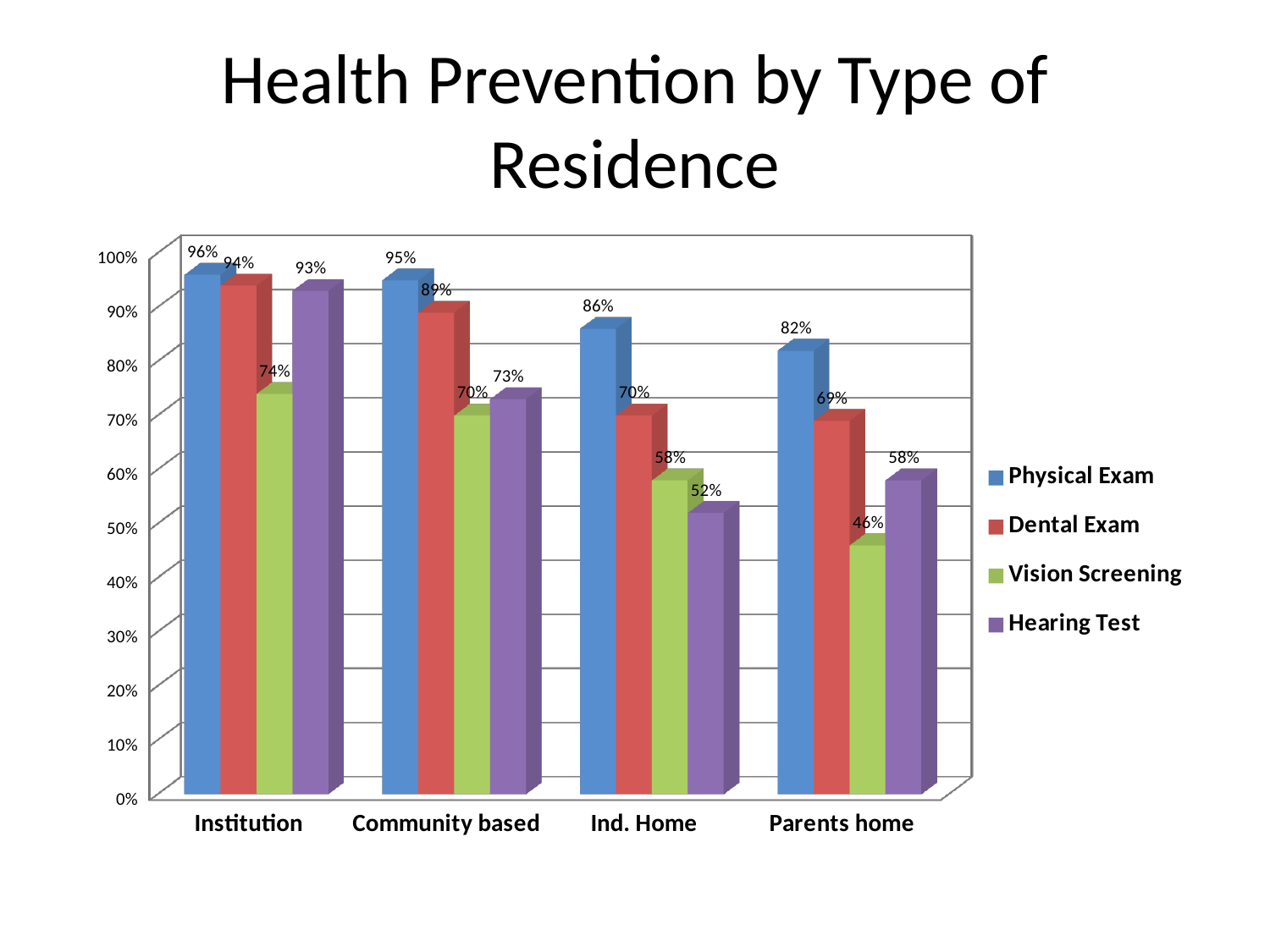
What is the Hearing Test value for Ind. Home? 52% Which residence type has the lowest Vision Screening value? Parents home What is the difference between the Physical Exam values for Institution and Parents home? 14% What is the Vision Screening value for Parents home? 46% Which residence type has the highest Physical Exam value? Institution What is the Dental Exam value for Community based? 89% What is the Physical Exam value for Institution? 96% How many series does the legend list? 4 What kind of chart is shown? Bar chart How many residence types are shown on the x axis? 4 Do the Physical Exam values rise or fall from Institution to Parents home? Fall Which is larger, the Dental Exam value for Ind. Home or the Hearing Test value for Community based? Hearing Test for Community based